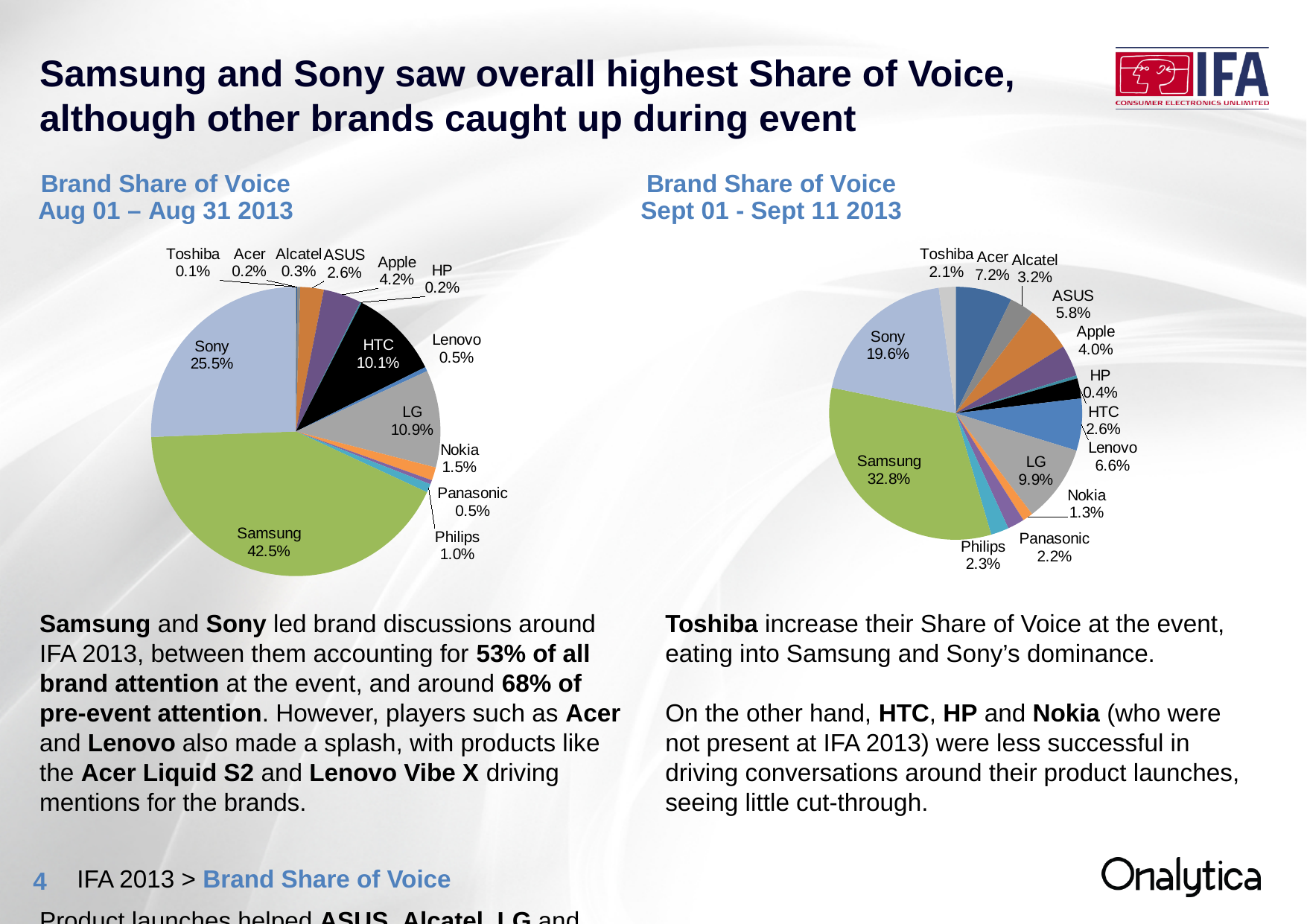
What is the combined share of Samsung and Sony in the 'Brand Share of Voice Aug 01 – Aug 31 2013' chart? 68% What type of chart is used for 'Brand Share of Voice Aug 01 – Aug 31 2013'? Pie chart In the 'Brand Share of Voice Sept 01 - Sept 11 2013' chart, which brand has the smallest share? HP In the 'Brand Share of Voice Aug 01 – Aug 31 2013' chart, which brand has the smallest share? Toshiba In the 'Brand Share of Voice Sept 01 - Sept 11 2013' chart, what share does Sony have? 19.6% In the 'Brand Share of Voice Aug 01 – Aug 31 2013' chart, which is larger, the share for HTC or the share for Apple? HTC How many brands are shown in the 'Brand Share of Voice Sept 01 - Sept 11 2013' chart? 14 What is the difference between Samsung's share in the Aug 01 – Aug 31 2013 chart and its share in the Sept 01 - Sept 11 2013 chart? 9.7% In the 'Brand Share of Voice Aug 01 – Aug 31 2013' chart, what share does Samsung have? 42.5% In the 'Brand Share of Voice Aug 01 – Aug 31 2013' chart, which brand has the largest share? Samsung In the 'Brand Share of Voice Sept 01 - Sept 11 2013' chart, which is larger, the share for LG or the share for Lenovo? LG In the 'Brand Share of Voice Sept 01 - Sept 11 2013' chart, what share does Acer have? 7.2%